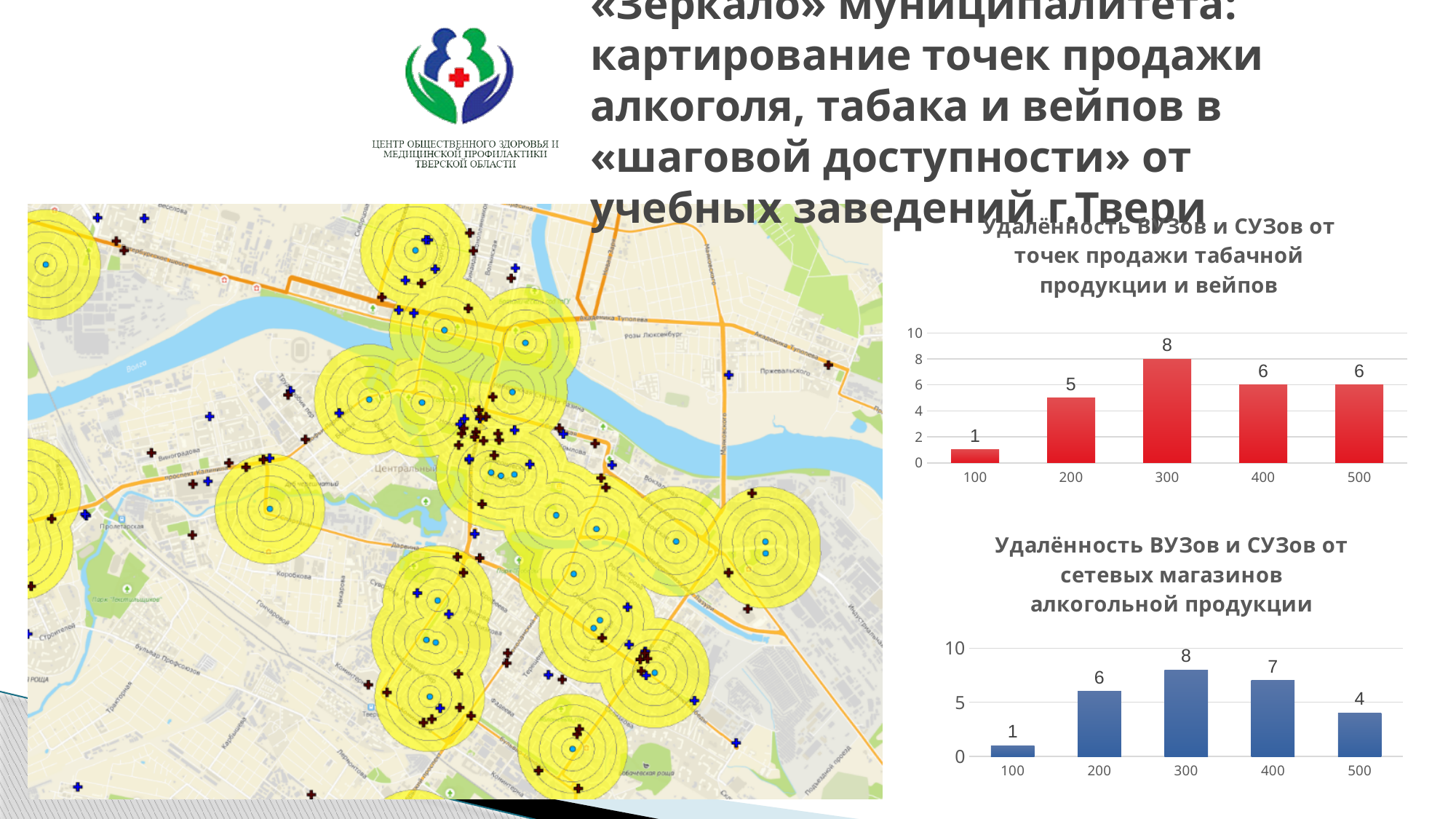
In the bottom chart (chain alcohol stores), what is the value for the 400 category? 7 In the bottom chart (chain alcohol stores), what is the difference between the values for 300 and 500? 4 In the top chart (tobacco and vape sales points), which category has the highest value? 300 In the top chart (tobacco and vape sales points), what is the value for the 300 category? 8 In the bottom chart (chain alcohol stores), which is larger: the value for 200 or the value for 500? 200 In the bottom chart (chain alcohol stores), what is the value for the 500 category? 4 In the top chart (tobacco and vape sales points), what is the difference between the values for 300 and 100? 7 In the bottom chart (chain alcohol stores), which category has the highest value? 300 In the top chart (tobacco and vape sales points), what is the value for the 200 category? 5 In the top chart (tobacco and vape sales points), how many categories are shown on the x axis? 5 What type of chart is the bottom chart (chain alcohol stores)? Bar chart In the top chart (tobacco and vape sales points), which category has the lowest value? 100